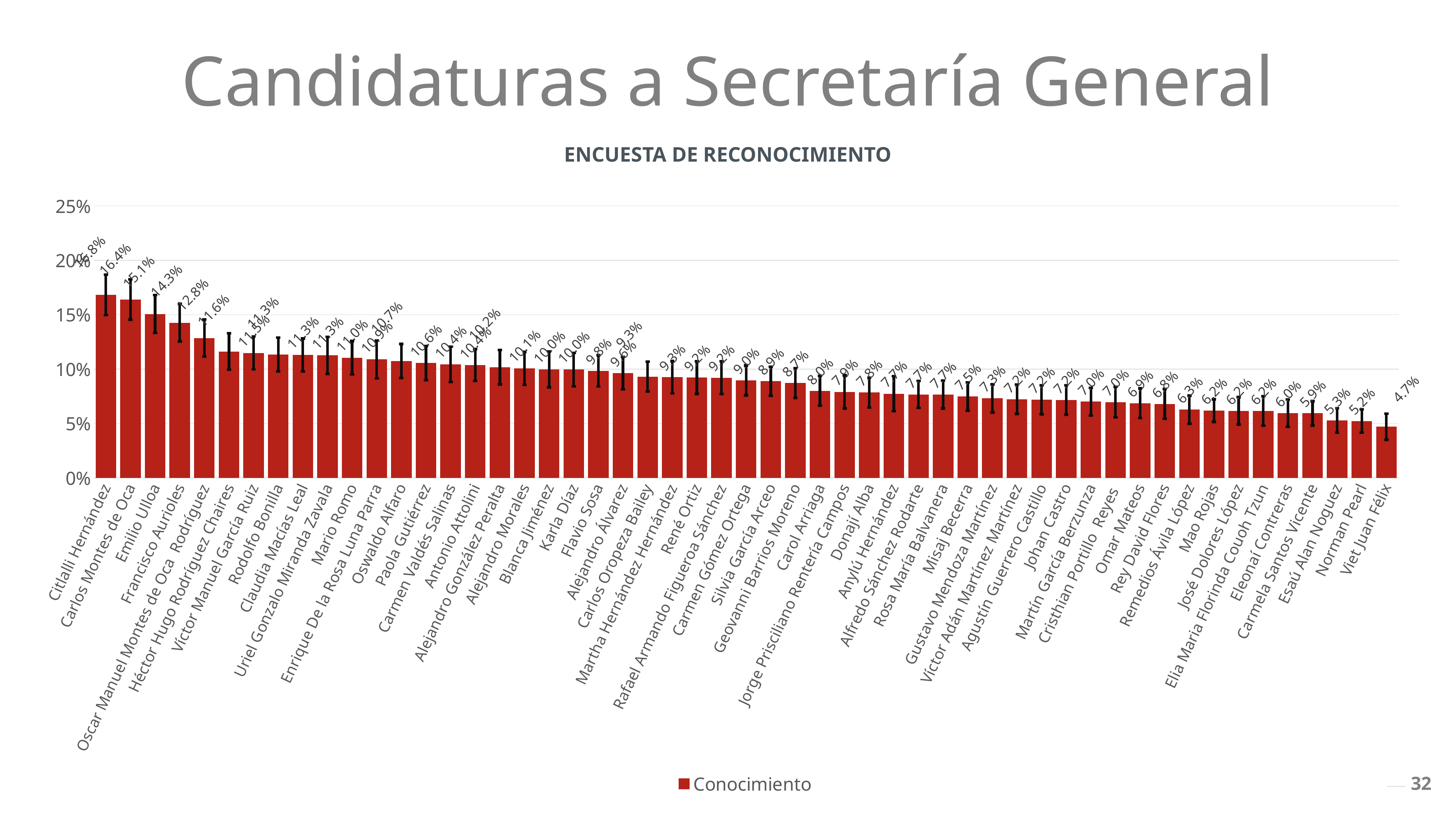
What is the Conocimiento value for Viet Juan Félix? 4.7% What is the difference between the Conocimiento values of Emilio Ulloa and Viet Juan Félix? 10.4% Who has a higher Conocimiento value, Francisco Aurioles or Oswaldo Alfaro? Francisco Aurioles What is the Conocimiento value for Carol Arriaga? 8.0% Do the Conocimiento values rise or fall from left to right along the x axis? Fall What is the Conocimiento value for Emilio Ulloa? 15.1% Which candidate has the highest Conocimiento value? Citlalli Hernández Which candidate has the lowest Conocimiento value? Viet Juan Félix What is the Conocimiento value for Mario Romo? 11.0% What is the name of the series shown in the legend? Conocimiento What type of chart is shown on the slide? Bar chart How many series does the legend list? 1